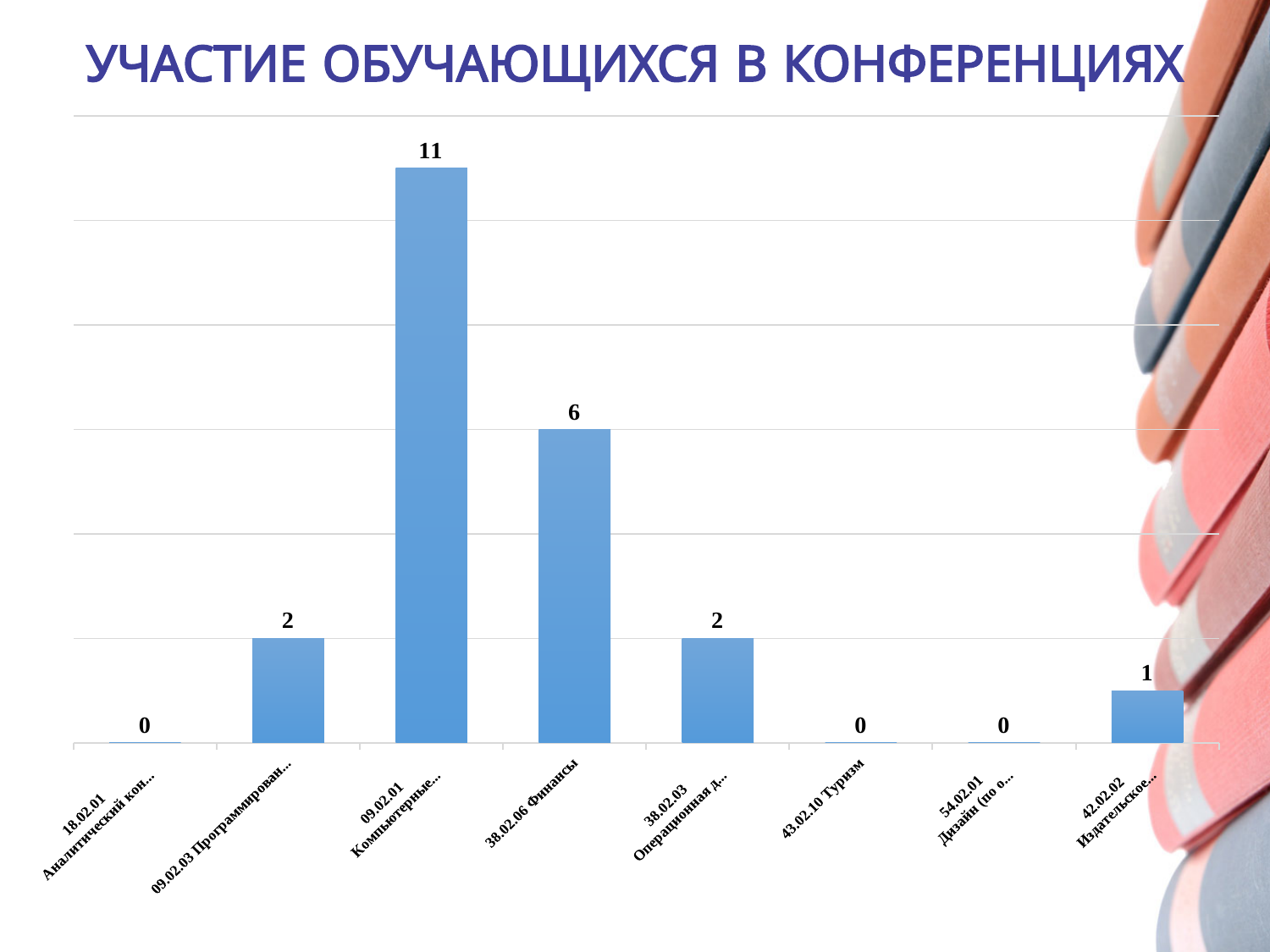
How many categories have a value of 0? 3 What is the title of the chart? УЧАСТИЕ ОБУЧАЮЩИХСЯ В КОНФЕРЕНЦИЯХ What is the value for 38.02.06 Финансы? 6 How many categories are plotted in the chart? 8 What is the value for 09.02.01 Компьютерные...? 11 What is the value for 42.02.02 Издательское...? 1 Which category has the highest value? 09.02.01 Компьютерные... What is the value for 09.02.03 Программирован...? 2 What is the difference between the values for 09.02.01 Компьютерные... and 38.02.06 Финансы? 5 Which is larger, the value for 38.02.06 Финансы or the value for 38.02.03 Операционная д...? 38.02.06 Финансы What type of chart is shown on the slide? bar chart What is the value for 43.02.10 Туризм? 0